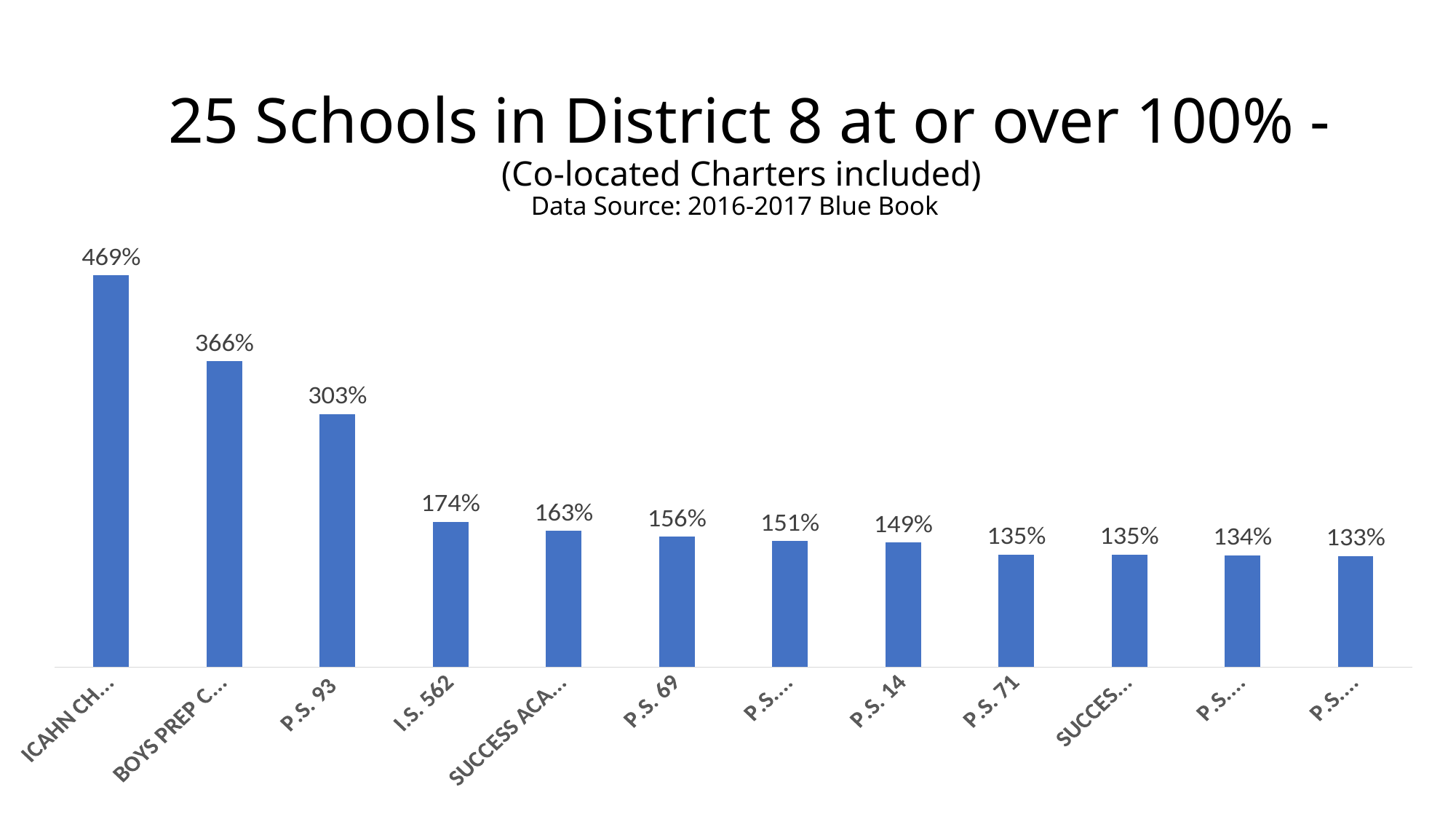
How many bars are shown on the chart? 12 What is the value for P.S. 93? 303% Do the values rise or fall from left to right across the chart? Fall What is the highest value shown on the chart? 469% What is the value for P.S. 71? 135% What kind of chart is shown on the slide? Bar chart What is the value for I.S. 562? 174% What is the difference between the values for P.S. 93 and I.S. 562? 129% What is the value for P.S. 14? 149% Which has a larger value, P.S. 69 or P.S. 14? P.S. 69 What is the lowest value shown on the chart? 133% What is the value for P.S. 69? 156%